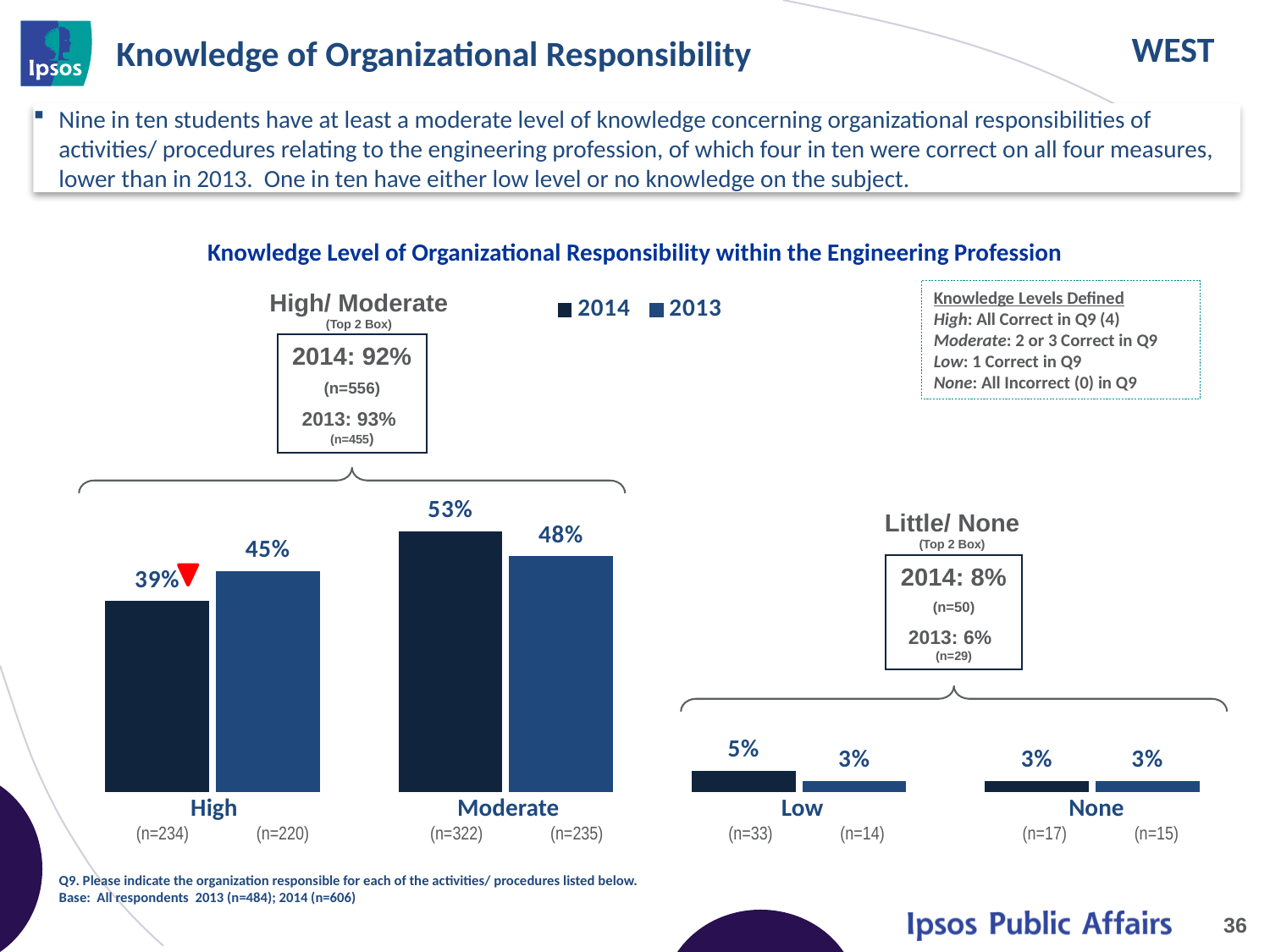
What is the 2013 value for the Moderate category? 48% What is the 2014 value for the High category? 39% What is the 2013 value for the None category? 3% How many categories are shown on the x axis of the chart? 4 What is the 2014 value for the Low category? 5% What is the difference between the 2014 and 2013 values for the Moderate category? 5% How many series does the legend list? 2 What is the difference between the 2013 and 2014 values for the High category? 6% Which is larger for the Low category, the 2014 value or the 2013 value? 2014 What kind of chart is shown on the slide? Bar chart Which category has the highest 2014 value? Moderate